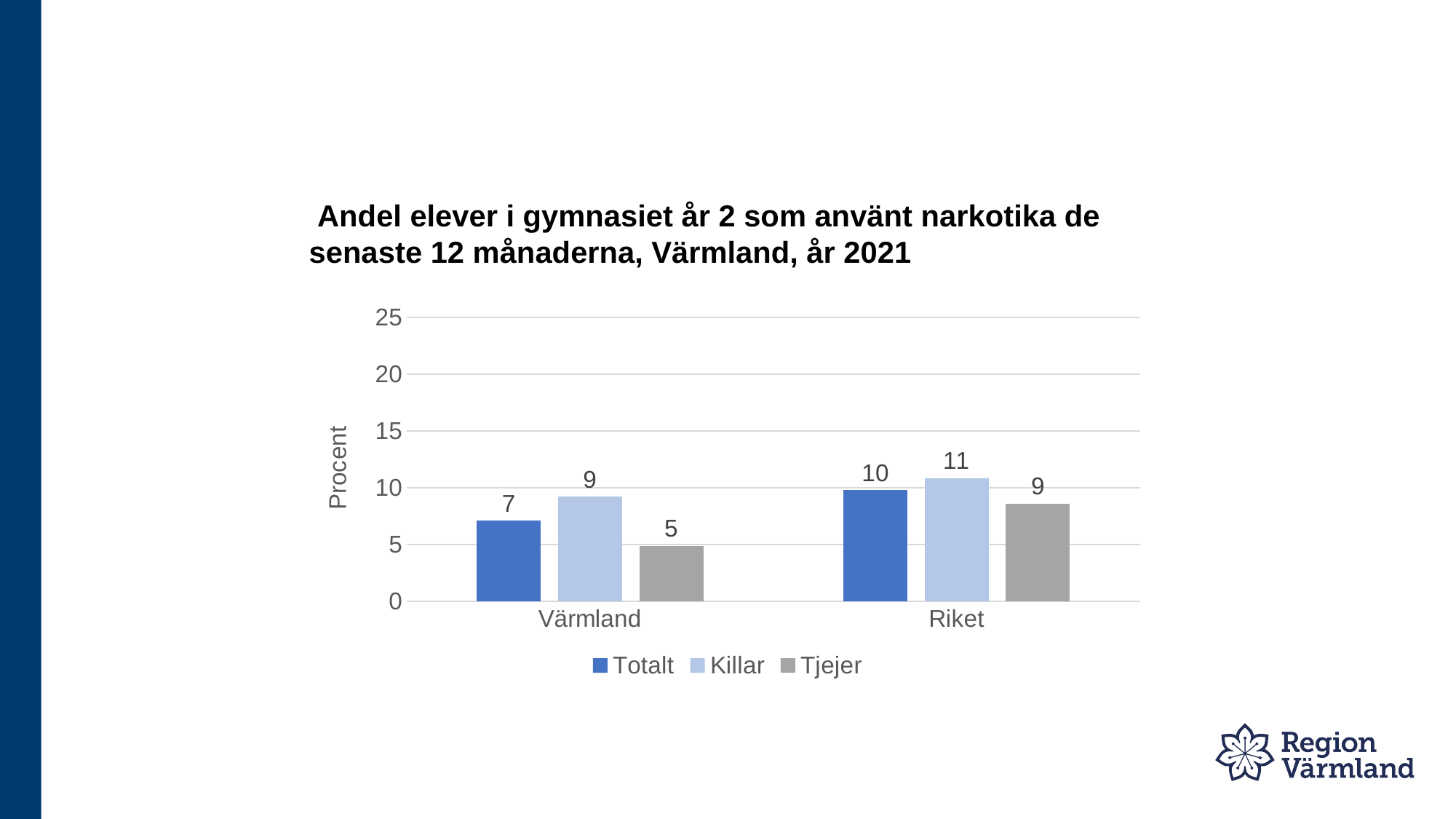
Which series has the lowest value in Värmland? Tjejer What is the value for Killar in Värmland? 9 What is the value for Totalt in Riket? 10 Which series has the highest value in Riket? Killar How many categories are shown on the x axis? 2 Is the value for Killar in Riket greater or less than 10? greater What is the difference between the Killar and Tjejer values in Värmland? 4 What is the label of the y axis? Procent What is the value for Tjejer in Riket? 9 Which is larger, the Totalt value for Värmland or the Totalt value for Riket? Riket How many series does the legend list? 3 What kind of chart is shown on the slide? Bar chart